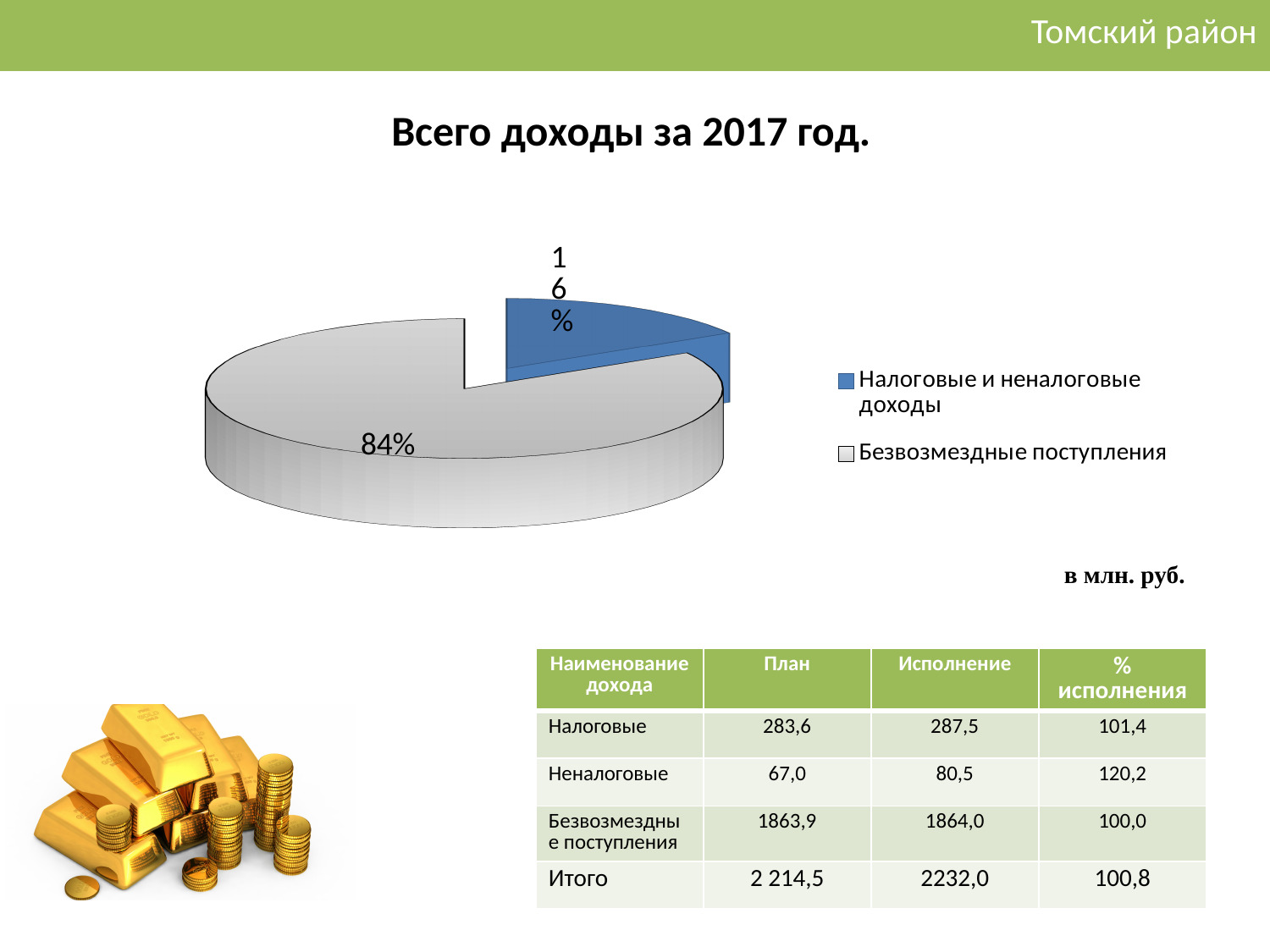
How many slices does the pie chart have? 2 Which slice of the pie chart is the smallest? Налоговые и неналоговые доходы What colour is the "Налоговые и неналоговые доходы" slice in the pie chart? Blue Which slice of the pie chart is the largest? Безвозмездные поступления What is the title of the chart on the slide? Всего доходы за 2017 год. How many entries does the legend of the pie chart list? 2 Which is larger: the share for "Безвозмездные поступления" or the share for "Налоговые и неналоговые доходы"? Безвозмездные поступления What kind of chart is shown on the slide? Pie chart What share of the pie does "Налоговые и неналоговые доходы" represent? 16% What is the difference in percentage points between the "Безвозмездные поступления" slice and the "Налоговые и неналоговые доходы" slice? 68 What share of the pie does "Безвозмездные поступления" represent? 84%